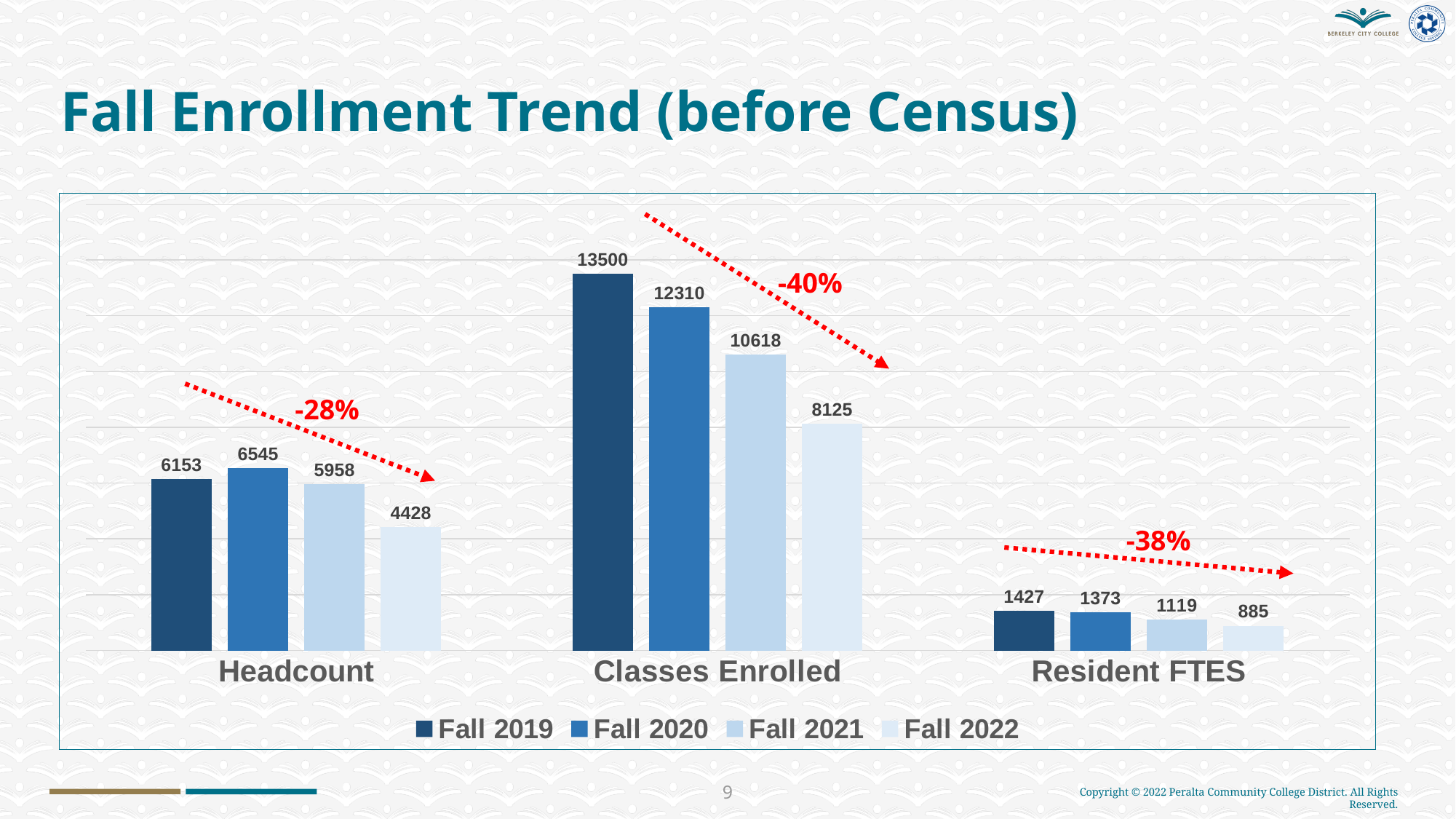
What is the difference between the Classes Enrolled values for Fall 2019 and Fall 2022? 5375 What kind of chart is shown on the slide? Bar chart How many categories are shown on the x axis? 3 Which series has the highest Headcount value? Fall 2020 What is the Headcount value for Fall 2022? 4428 Which series has the lowest Classes Enrolled value? Fall 2022 What is the Resident FTES value for Fall 2021? 1119 What is the difference between the Resident FTES values for Fall 2019 and Fall 2020? 54 What percentage change is annotated above the Classes Enrolled bars? -40% What is the Classes Enrolled value for Fall 2019? 13500 How many series does the legend list? 4 Which is larger, the Headcount for Fall 2019 or for Fall 2021? Fall 2019